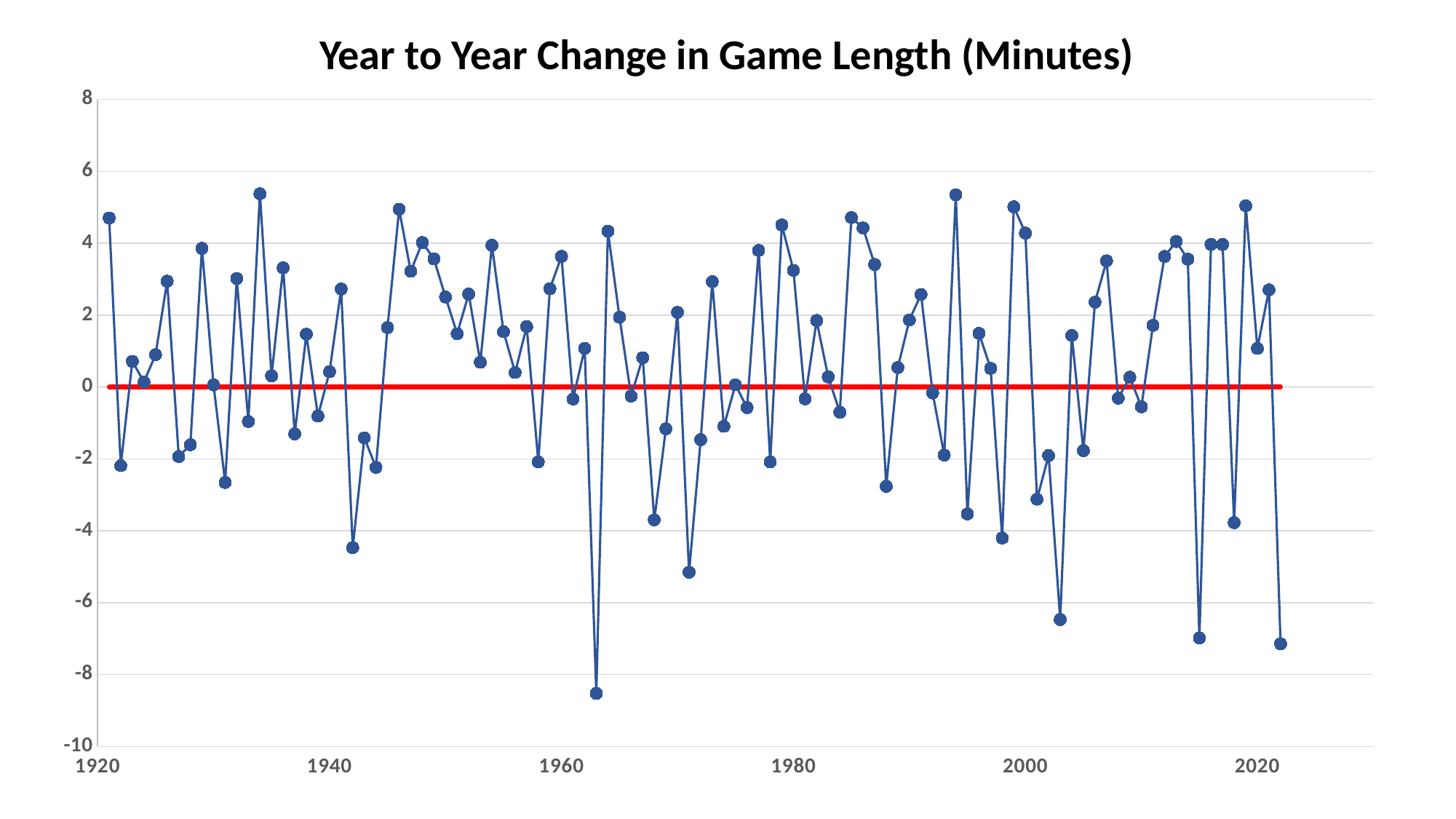
What is the title of the chart? Year to Year Change in Game Length (Minutes) Which is larger, the value for 2000 or the value for 2020? 2000 In which decade does the lowest value on the chart occur? 1960s Is the value for 1960 greater or less than 2? greater Is the value for 2020 greater or less than 2? less Which is larger, the value for 1960 or the value for 1940? 1960 What is the highest value shown on the vertical axis? 8 Is the lowest value on the chart greater or less than -8? less At what value is the horizontal red line drawn? 0 What kind of chart is shown on the slide? line chart